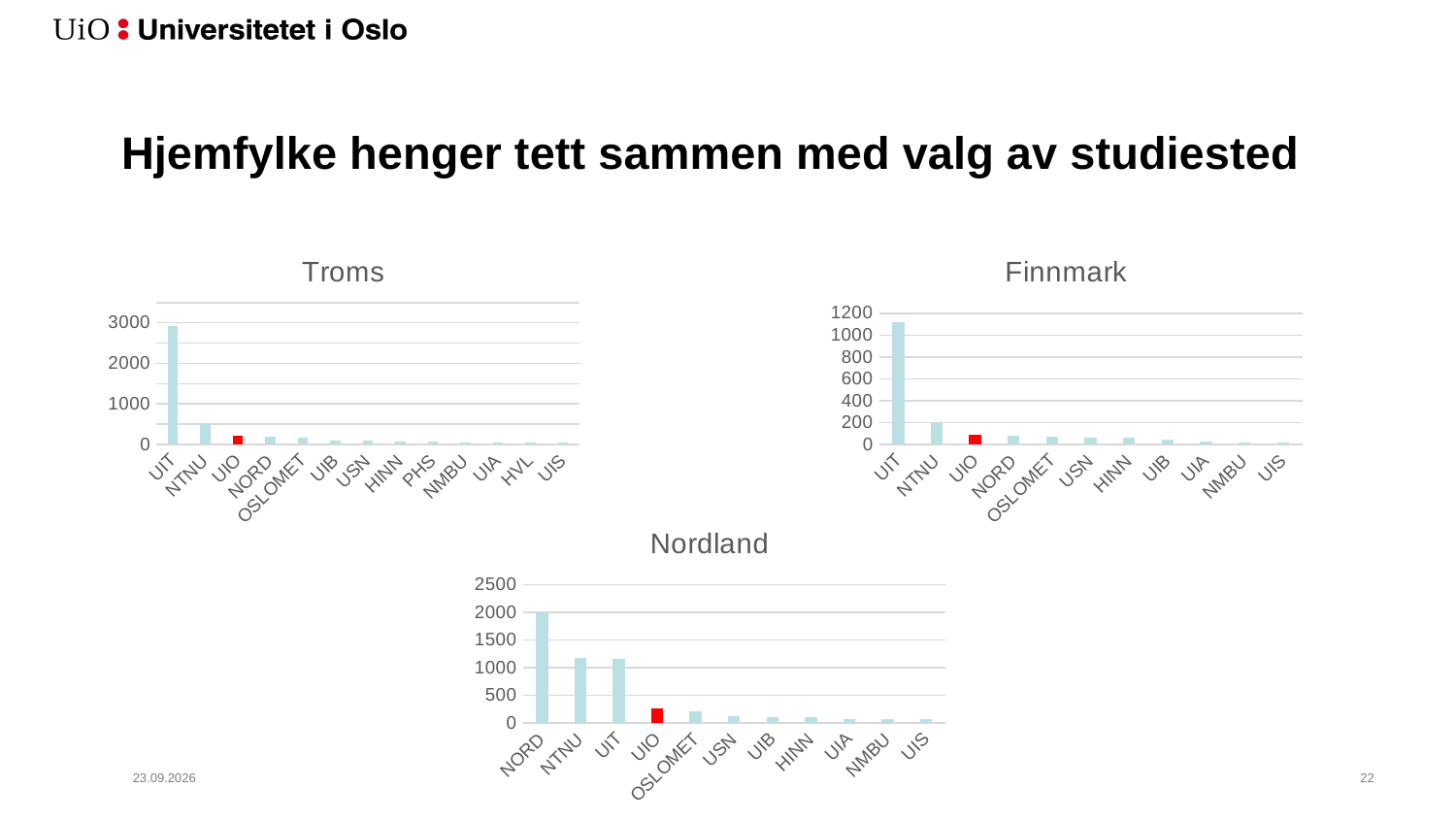
In the Nordland chart, is the value for UIO greater or less than 500? less How many categories are shown on the x axis of the Finnmark chart? 11 What type of chart is the Troms chart? bar chart How many categories are shown on the x axis of the Troms chart? 13 In the Troms chart, which category has the highest value? UIT In the Finnmark chart, which category has the highest value? UIT In the Troms chart, which is larger, the value for NTNU or the value for UIO? NTNU In the Troms chart, is the value for UIT greater or less than 2000? greater In the Finnmark chart, is the value for UIT greater or less than 1000? greater In the Nordland chart, which category has the highest value? NORD In the Nordland chart, which bar is coloured red? UIO How many charts are shown on the slide? 3